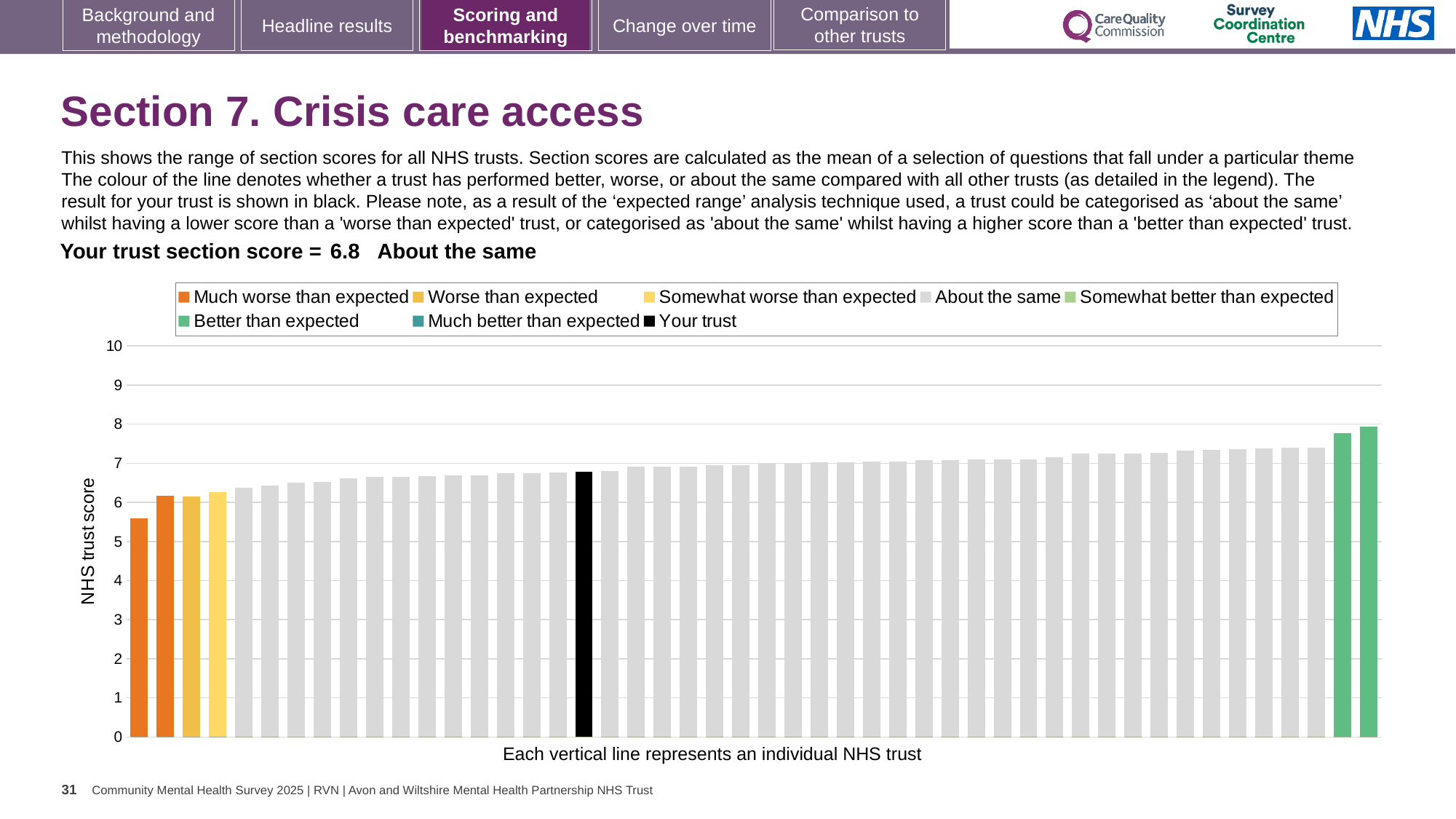
What is the section score for your trust shown on the slide? 6.8 How many entries does the chart legend list? 8 What kind of chart is shown on the slide? bar chart What is the label on the vertical axis of the chart? NHS trust score Do the bar values rise or fall from left to right along the x axis? rise Which category is your trust placed in for this section? About the same Is the value of the leftmost (lowest) bar greater or less than 6? less Is the value of the tallest bar greater or less than 7? greater Is the value of the black bar (your trust) greater or less than 5? greater Which legend category do the two tallest bars belong to? Better than expected Which legend category does the shortest bar belong to? Much worse than expected Which is taller: the black bar for your trust or the leftmost orange bar? the black bar for your trust